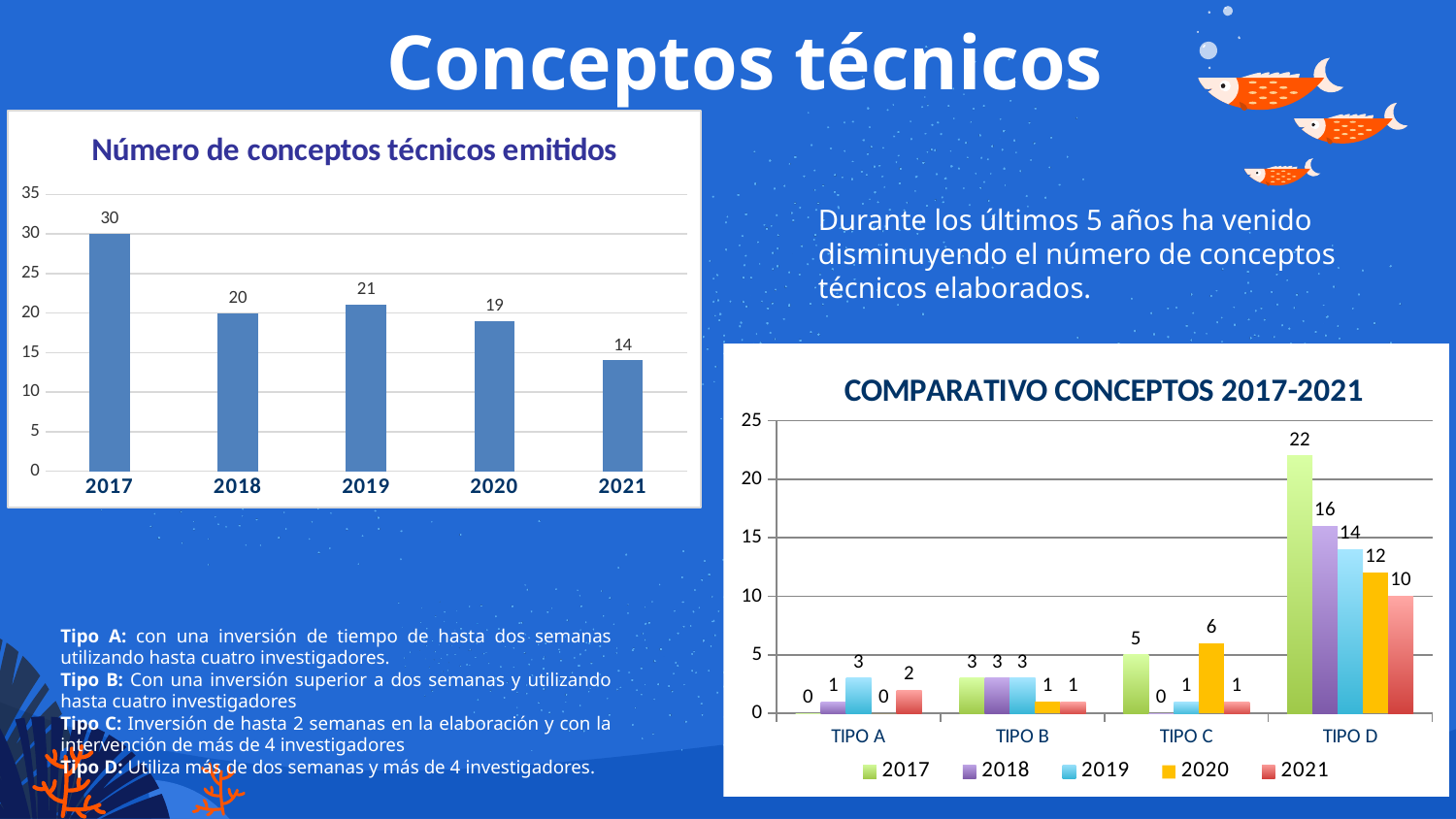
In the chart 'Número de conceptos técnicos emitidos', what is the difference between the values for 2017 and 2021? 16 What kind of chart is 'COMPARATIVO CONCEPTOS 2017-2021'? bar chart In the chart 'Número de conceptos técnicos emitidos', which is larger, the value for 2018 or the value for 2019? 2019 In the chart 'COMPARATIVO CONCEPTOS 2017-2021', how many series does the legend list? 5 In the chart 'COMPARATIVO CONCEPTOS 2017-2021', what is the difference between the 2017 and 2021 values in TIPO D? 12 In the chart 'Número de conceptos técnicos emitidos', how many years are shown on the x axis? 5 In the chart 'Número de conceptos técnicos emitidos', what is the value for 2017? 30 In the chart 'COMPARATIVO CONCEPTOS 2017-2021', which category has the highest value for 2019? TIPO D In the chart 'COMPARATIVO CONCEPTOS 2017-2021', what is the value for 2017 in TIPO D? 22 In the chart 'Número de conceptos técnicos emitidos', do the values generally rise or fall from 2017 to 2021? fall In the chart 'Número de conceptos técnicos emitidos', which year has the lowest value? 2021 In the chart 'COMPARATIVO CONCEPTOS 2017-2021', what is the value for 2020 in TIPO C? 6